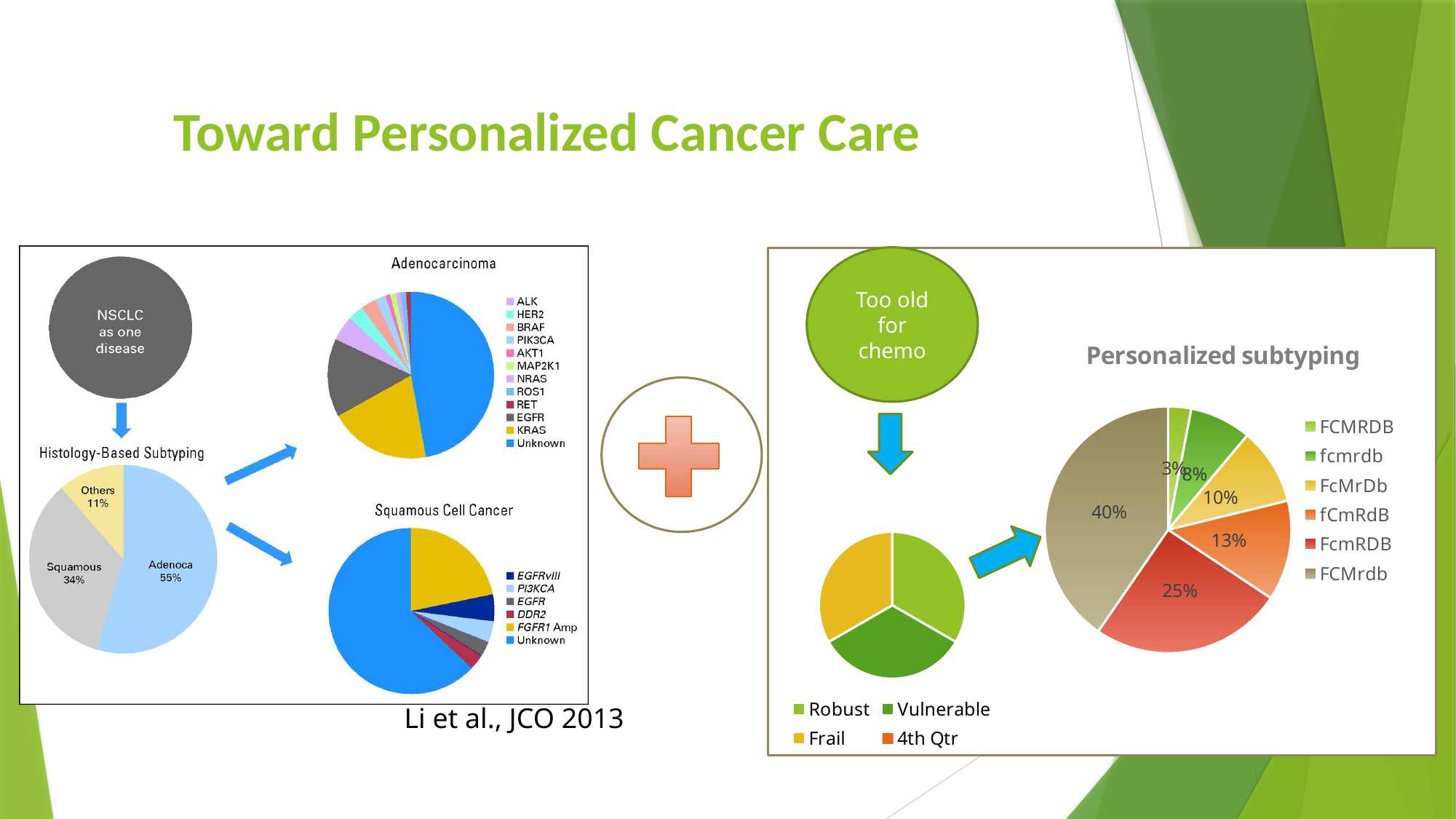
How many slices does the Histology-Based Subtyping pie chart have? 3 In the Personalized subtyping pie chart, what is the difference between the FCMrdb and FcmRDB shares? 15% In the Histology-Based Subtyping pie chart, which category has the smallest share? Others In the Personalized subtyping pie chart, which is larger, fCmRdB or FcMrDb? fCmRdB What kind of chart is the Squamous Cell Cancer chart? pie chart How many entries does the legend of the Personalized subtyping pie chart list? 6 In the Personalized subtyping pie chart, which category has the smallest share? FCMRDB In the Histology-Based Subtyping pie chart, what percentage is Squamous? 34% In the Histology-Based Subtyping pie chart, what percentage is Adenoca? 55% In the Personalized subtyping pie chart, what percentage is FCMrdb? 40% In the Histology-Based Subtyping pie chart, what is the difference between the Adenoca and Squamous shares? 21%